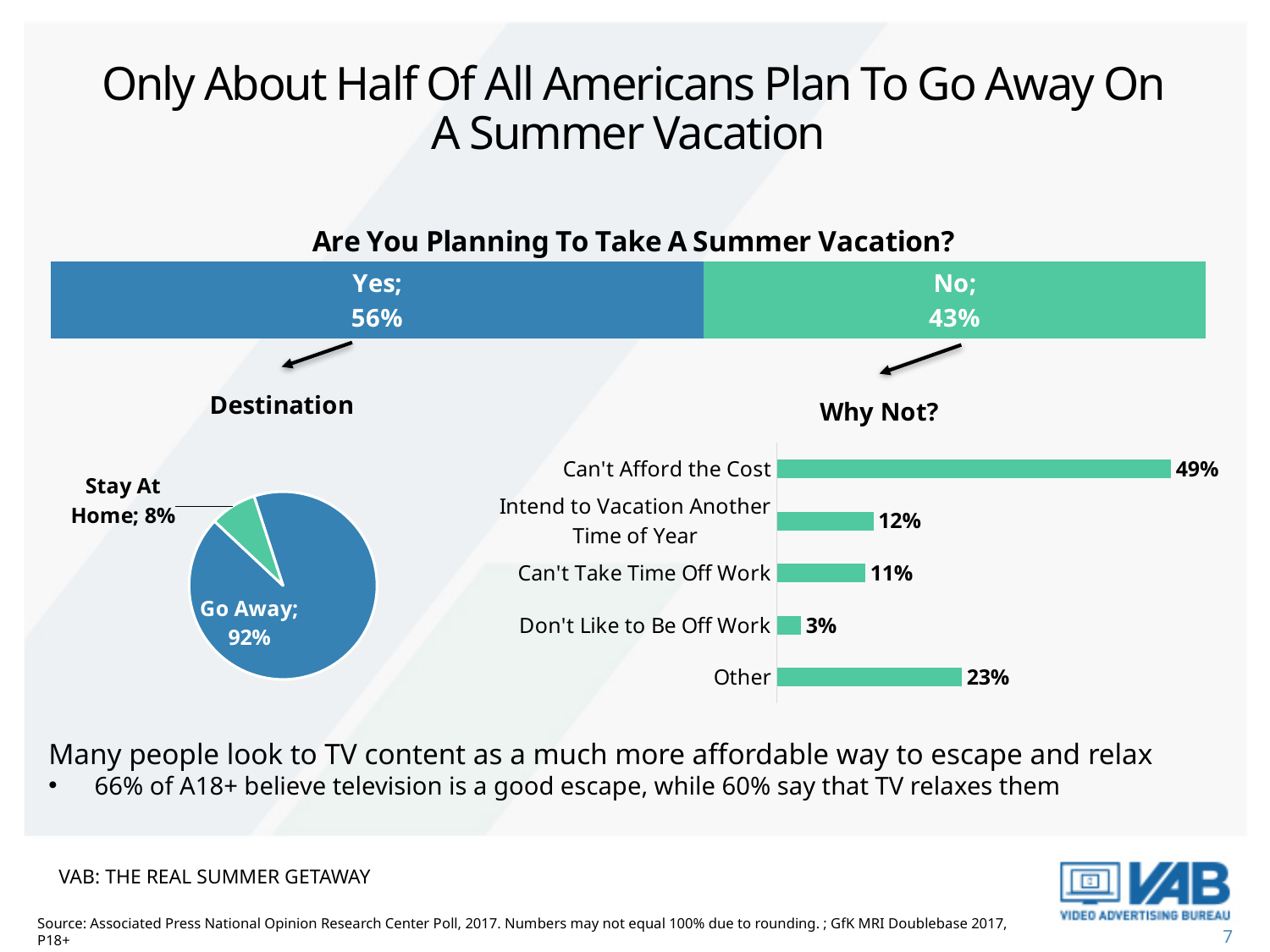
In the 'Why Not?' chart, what is the difference between 'Other' and 'Can't Take Time Off Work'? 12% In the 'Destination' pie chart, what share of the pie is 'Go Away'? 92% What kind of chart is the 'Why Not?' chart? Bar chart In the 'Destination' pie chart, what is the value for 'Stay At Home'? 8% In the 'Why Not?' chart, which is larger: 'Intend to Vacation Another Time of Year' or 'Other'? Other In the 'Are You Planning To Take A Summer Vacation?' chart, what is the difference between the Yes and No percentages? 13% In the 'Why Not?' chart, which category has the highest value? Can't Afford the Cost How many slices does the 'Destination' pie chart have? 2 In the 'Why Not?' chart, which category has the lowest value? Don't Like to Be Off Work In the 'Are You Planning To Take A Summer Vacation?' chart, what percentage answered Yes? 56% In the 'Why Not?' chart, how many categories are shown? 5 In the 'Why Not?' chart, what is the value for 'Can't Afford the Cost'? 49%